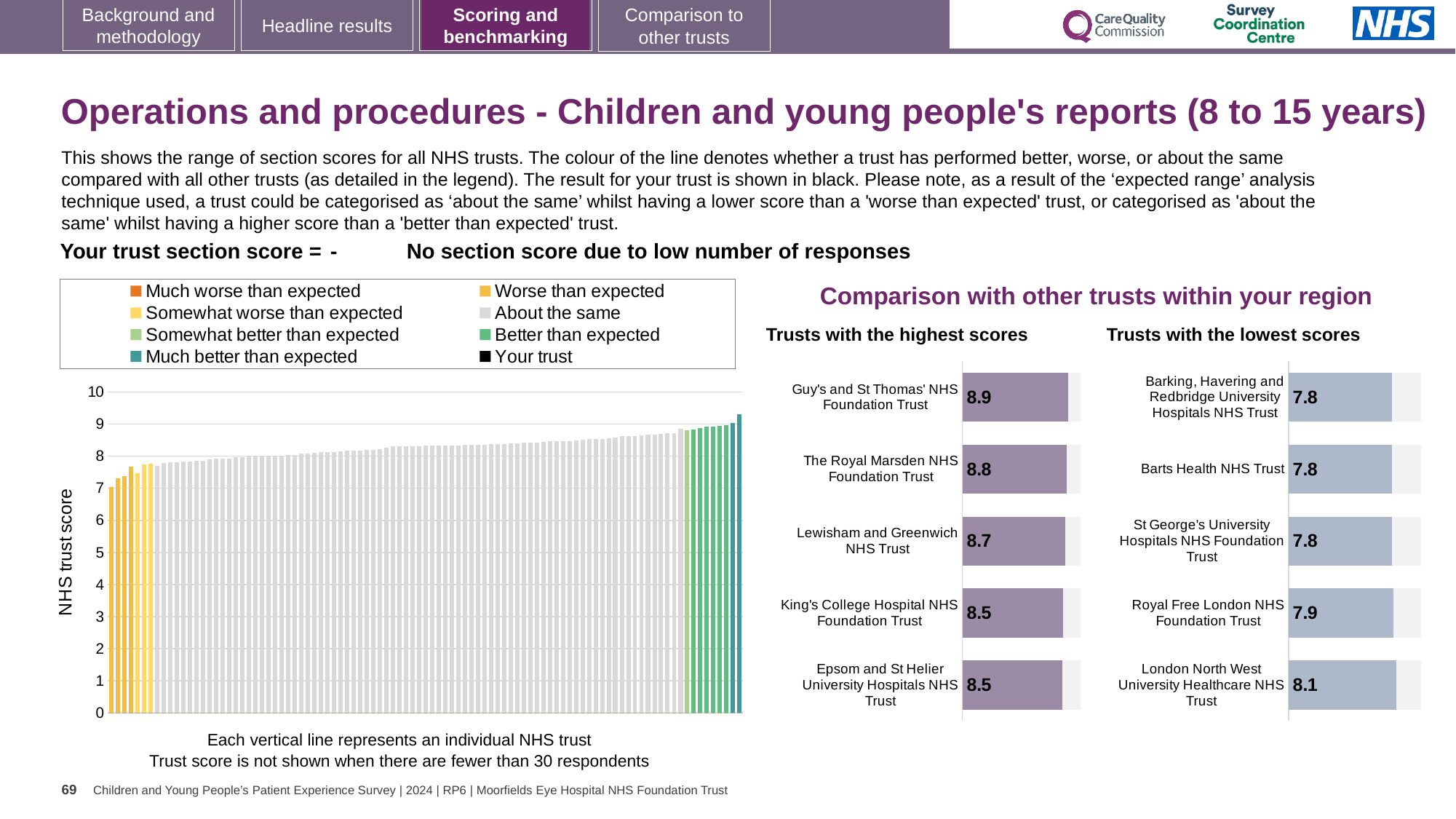
What kind of chart is the large chart on the left with the y-axis labelled 'NHS trust score'? Bar chart How many entries does the legend above the large 'NHS trust score' chart list? 8 In the 'Trusts with the highest scores' chart, which trust has the highest score? Guy's and St Thomas' NHS Foundation Trust In the 'Trusts with the highest scores' chart, what is the difference between the scores of Guy's and St Thomas' NHS Foundation Trust and King's College Hospital NHS Foundation Trust? 0.4 In the 'Trusts with the lowest scores' chart, what is the score for London North West University Healthcare NHS Trust? 8.1 In the 'Trusts with the highest scores' chart, which has the larger score: The Royal Marsden NHS Foundation Trust or King's College Hospital NHS Foundation Trust? The Royal Marsden NHS Foundation Trust How many trusts are shown in the 'Trusts with the lowest scores' chart? 5 In the 'Trusts with the lowest scores' chart, which trust has the highest score? London North West University Healthcare NHS Trust In the large 'NHS trust score' chart on the left, is the value of the leftmost bar greater or less than 8? less In the 'Trusts with the lowest scores' chart, what is the difference between the scores of London North West University Healthcare NHS Trust and Barts Health NHS Trust? 0.3 In the 'Trusts with the highest scores' chart, what is the score for Guy's and St Thomas' NHS Foundation Trust? 8.9 In the large 'NHS trust score' chart on the left, do the values rise or fall from left to right? Rise